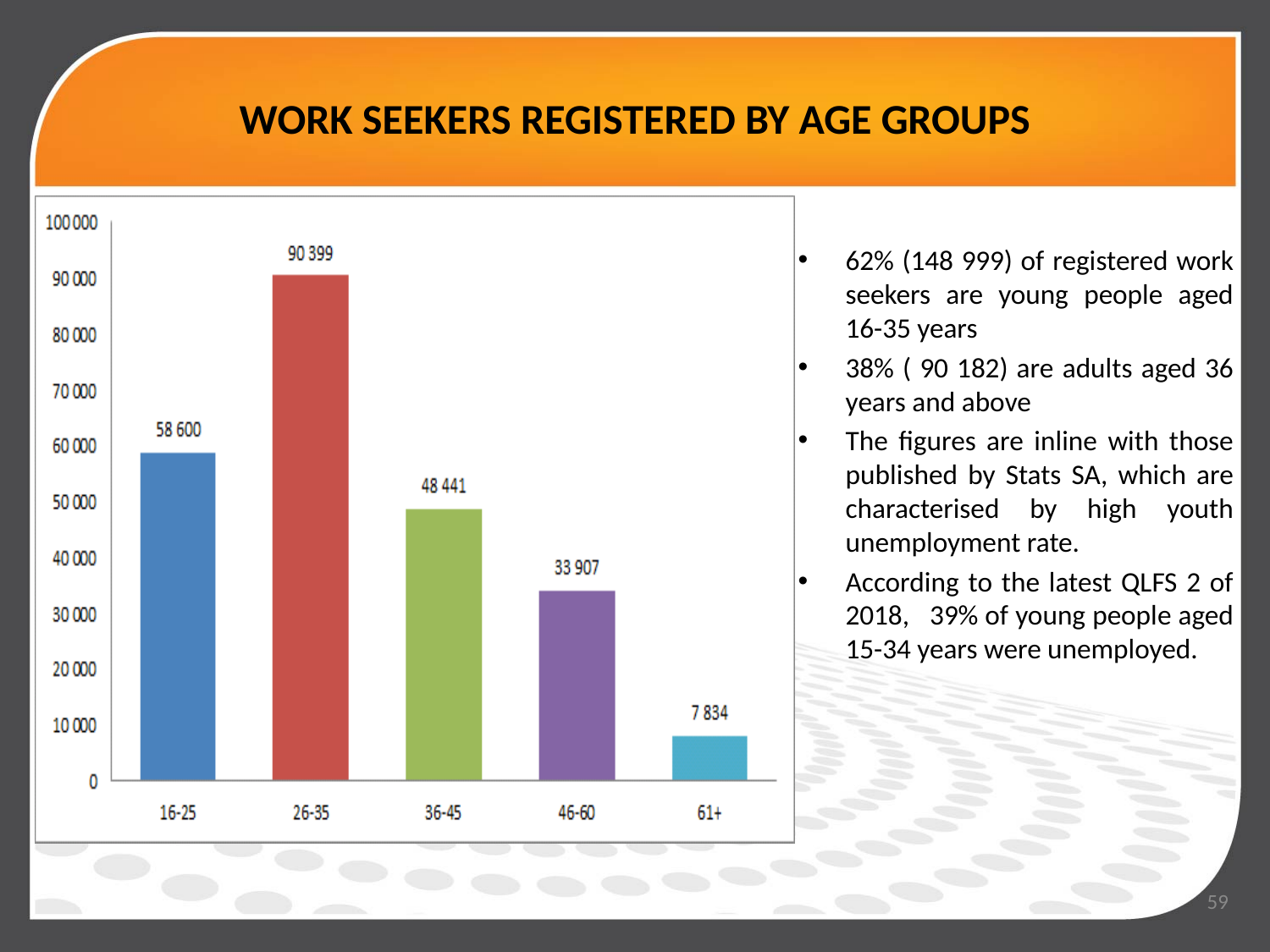
What is the difference between the values for the 26-35 and 16-25 age groups? 31 799 What is the number of registered work seekers in the 26-35 age group? 90 399 Which age group has the highest number of registered work seekers? 26-35 How many age groups are shown in the chart? 5 What is the value shown for the 36-45 age group? 48 441 Is the value for the 46-60 age group greater or less than 40 000? less What is the number of registered work seekers in the 61+ age group? 7 834 Which age group has the lowest number of registered work seekers? 61+ What is the difference between the values for the 36-45 and 46-60 age groups? 14 534 What type of chart is shown on the slide? bar chart Which age group has more registered work seekers, 16-25 or 36-45? 16-25 What is the total of the values for the 16-25 and 26-35 age groups? 148 999